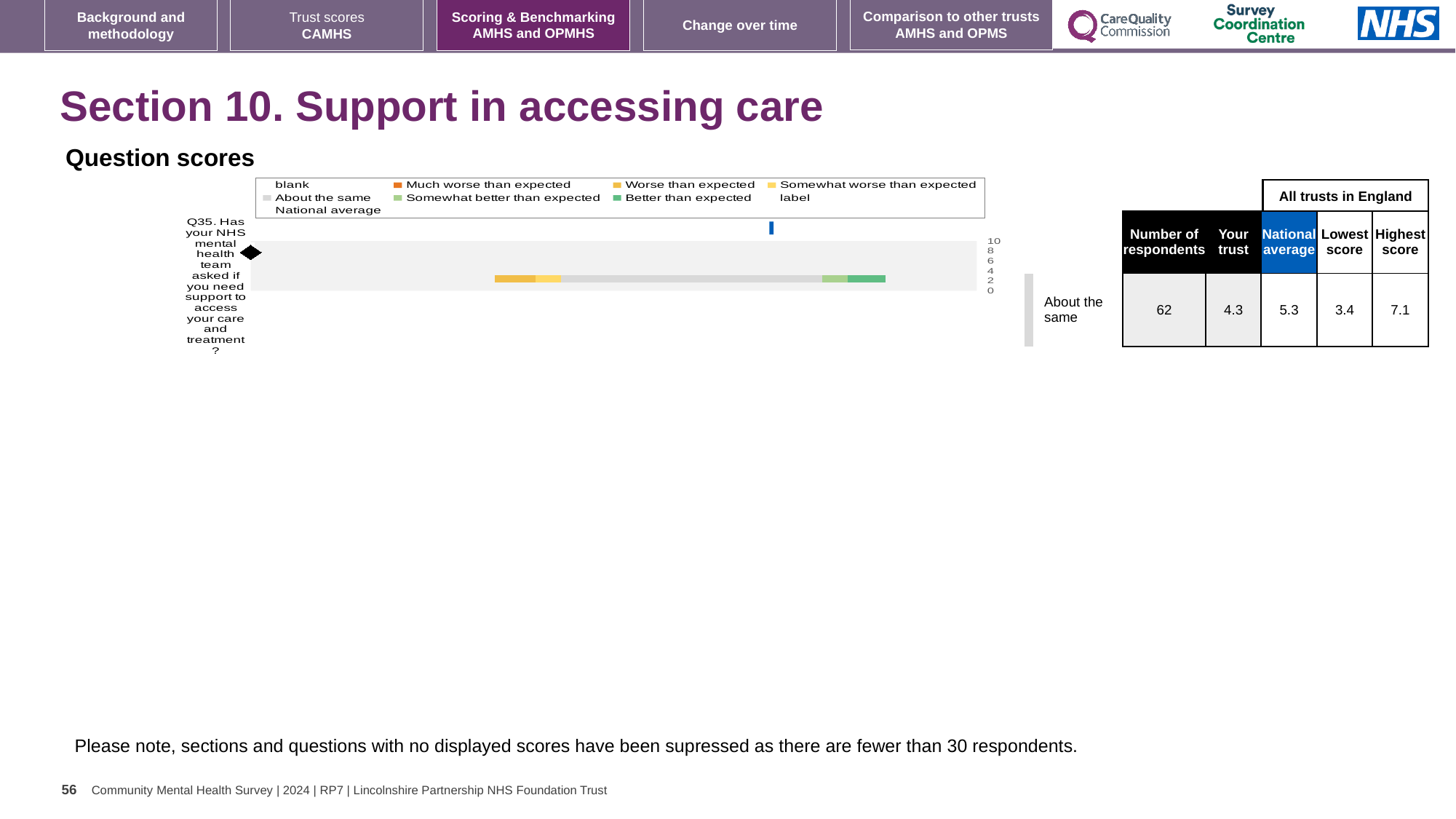
What is the highest score among all trusts in England for Q35? 7.1 What is the 'Your trust' score for Q35? 4.3 How many questions are plotted in the Question scores chart? 1 What is the national average score for Q35? 5.3 What is the lowest score among all trusts in England for Q35? 3.4 For Q35, which is larger: the 'Your trust' score or the national average? National average What benchmark category is the trust's Q35 score placed in? About the same What is the number of respondents for Q35? 62 What is the difference between the national average and the 'Your trust' score for Q35? 1.0 Which question number is shown in the Question scores chart? Q35 What is the difference between the highest score and the lowest score for Q35? 3.7 What type of chart is used to show the Q35 question score? bar chart